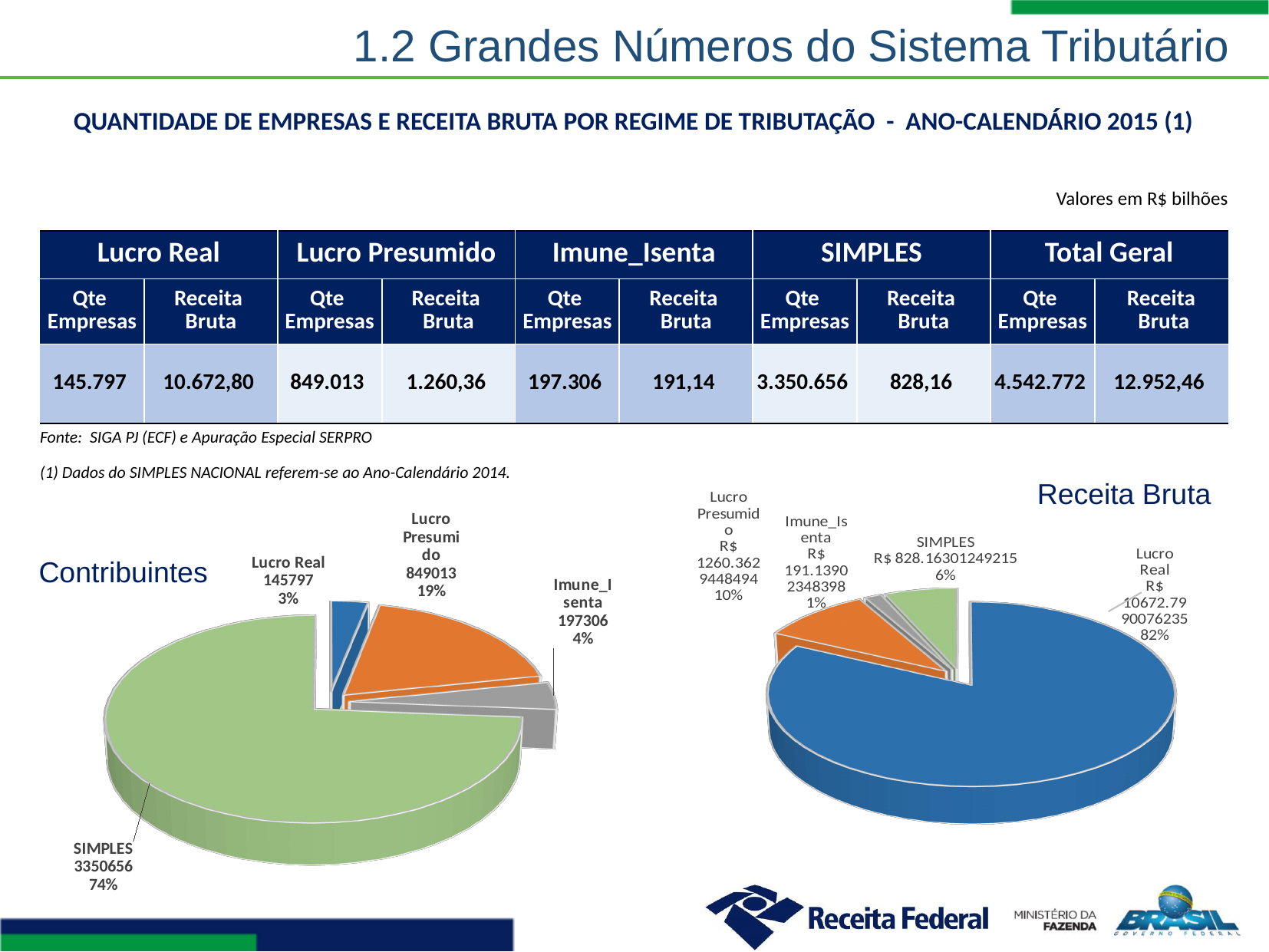
In the Receita Bruta chart, which category has the smallest slice? Imune_Isenta In the Contribuintes chart, which category has the smallest slice? Lucro Real In the Receita Bruta chart, which is larger, the slice for Lucro Presumido or the slice for SIMPLES? Lucro Presumido In the Contribuintes chart, what is the value shown for SIMPLES? 3350656 In the Contribuintes chart, what is the value shown for Imune_Isenta? 197306 What type of chart is the Contribuintes chart? pie chart In the Contribuintes chart, what is the difference between the values for Lucro Presumido and Lucro Real? 703216 In the Receita Bruta chart, what share of the pie does Lucro Real represent? 82% In the Receita Bruta chart, what share of the pie does SIMPLES represent? 6% In the Contribuintes chart, which category has the largest slice? SIMPLES In the Contribuintes chart, what share of the pie does Lucro Presumido represent? 19% How many slices does the Contribuintes pie chart have? 4